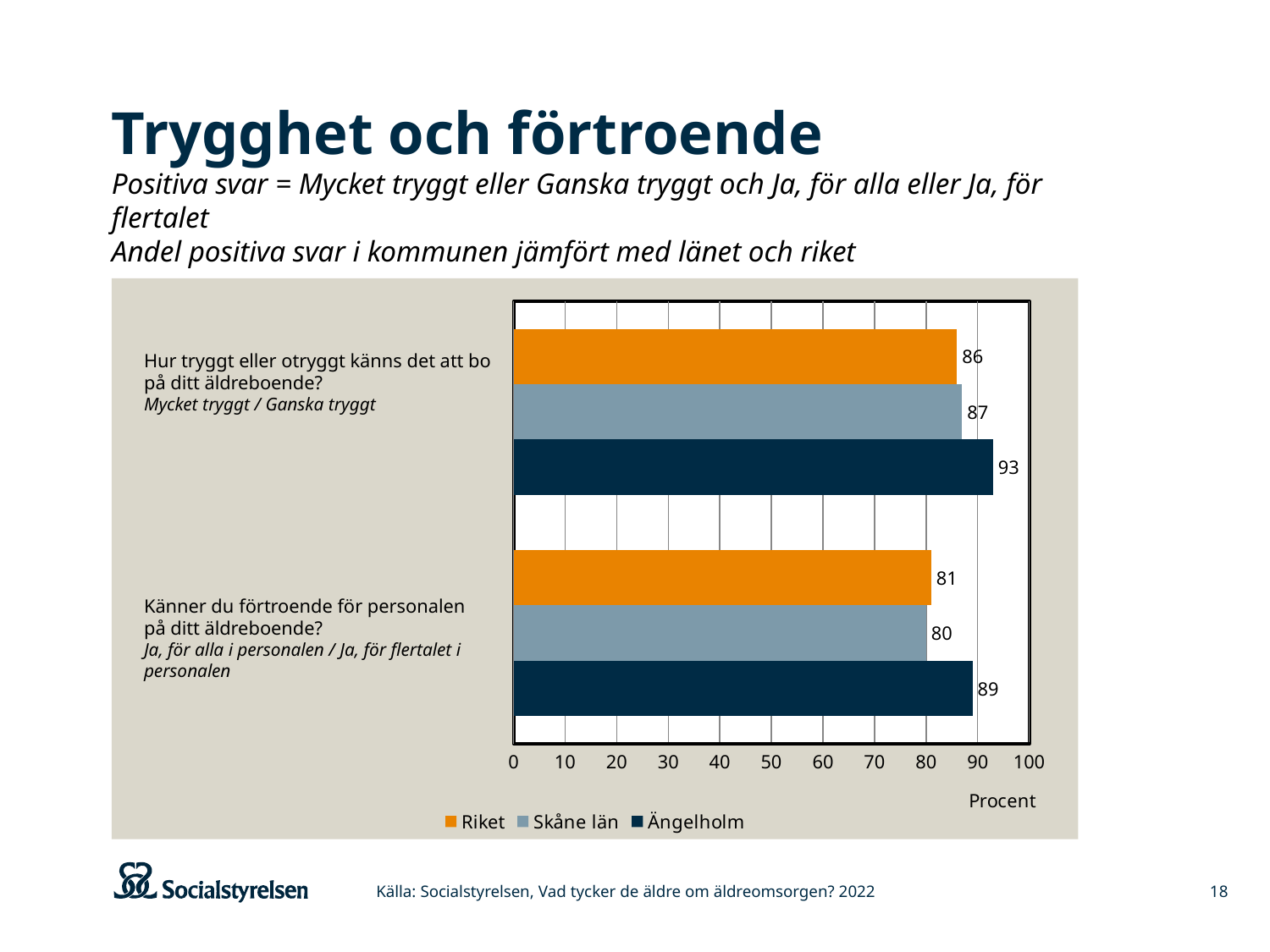
What is the value for Riket on the question "Hur tryggt eller otryggt känns det att bo på ditt äldreboende?"? 86 What unit is shown on the horizontal axis of the chart? Procent What is the difference between Ängelholm and Skåne län on the question "Känner du förtroende för personalen på ditt äldreboende?"? 9 What kind of chart is shown on the slide? Bar chart What is the difference between Ängelholm and Riket on the question "Hur tryggt eller otryggt känns det att bo på ditt äldreboende?"? 7 What is the value for Riket on the question "Känner du förtroende för personalen på ditt äldreboende?"? 81 What is the value for Ängelholm on the question "Hur tryggt eller otryggt känns det att bo på ditt äldreboende?"? 93 Which is larger: Ängelholm's value for "Hur tryggt eller otryggt känns det att bo på ditt äldreboende?" or Ängelholm's value for "Känner du förtroende för personalen på ditt äldreboende?"? Hur tryggt eller otryggt känns det att bo på ditt äldreboende? Which series has the highest value on the question "Känner du förtroende för personalen på ditt äldreboende?"? Ängelholm Which series has the lowest value on the question "Känner du förtroende för personalen på ditt äldreboende?"? Skåne län How many series does the legend list? 3 What is the value for Skåne län on the question "Känner du förtroende för personalen på ditt äldreboende?"? 80